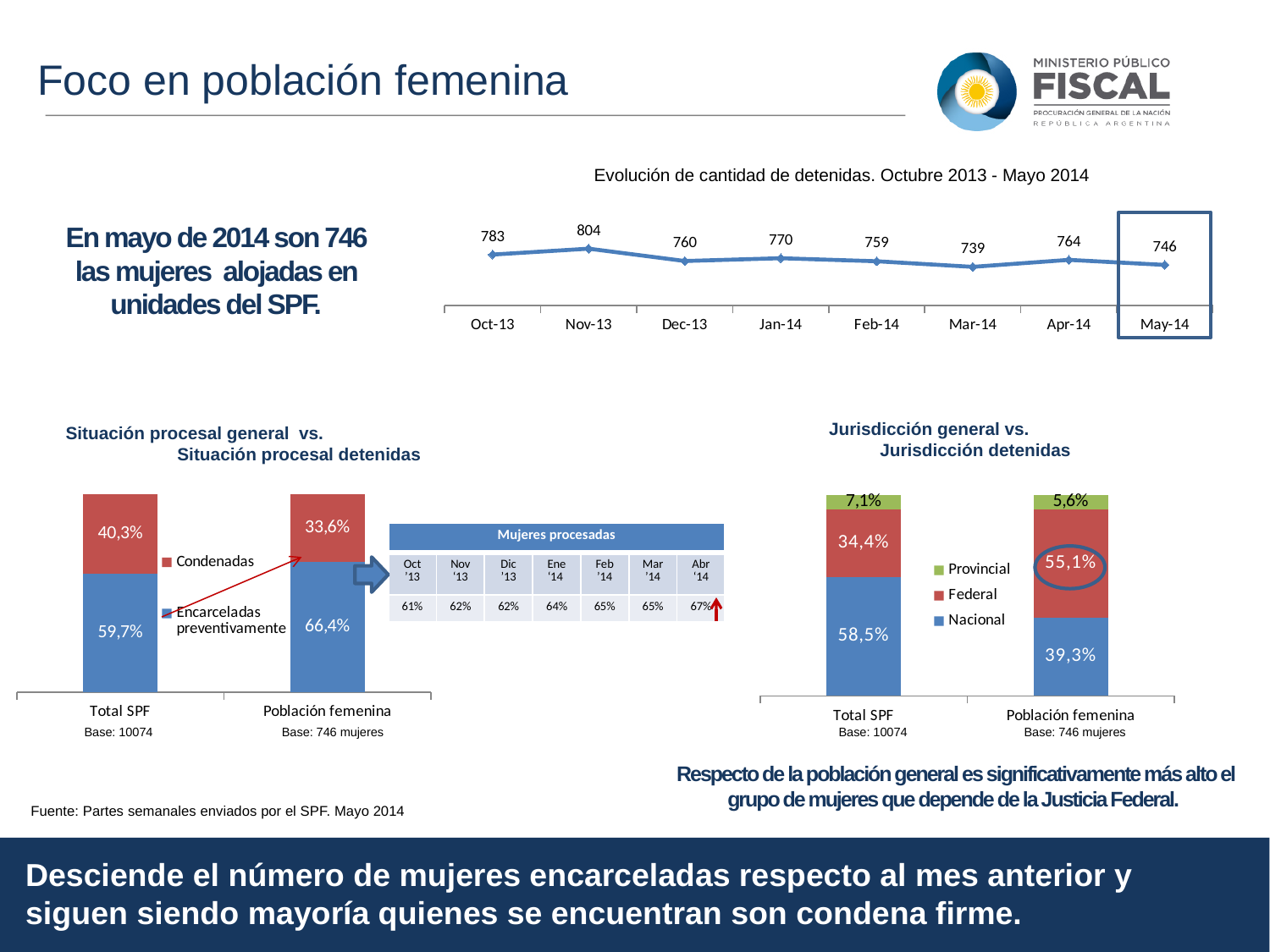
In the line chart 'Evolución de cantidad de detenidas', what is the value for Nov-13? 804 In the line chart 'Evolución de cantidad de detenidas', is the value for Oct-13 larger or smaller than the value for Dec-13? larger In the chart 'Jurisdicción general vs. Jurisdicción detenidas', what is the difference between the Nacional shares for Total SPF and Población femenina? 19,2% In the line chart 'Evolución de cantidad de detenidas', how many months are plotted? 8 In the line chart 'Evolución de cantidad de detenidas', what is the difference between the values for Apr-14 and May-14? 18 In the chart 'Situación procesal general vs. Situación procesal detenidas', what is the Condenadas share for Población femenina? 33,6% In the chart 'Jurisdicción general vs. Jurisdicción detenidas', what is the Federal share for Población femenina? 55,1% What kind of chart is 'Jurisdicción general vs. Jurisdicción detenidas'? stacked bar chart In the chart 'Situación procesal general vs. Situación procesal detenidas', what is the Encarceladas preventivamente share for Total SPF? 59,7% In the line chart 'Evolución de cantidad de detenidas', which month has the lowest value? Mar-14 In the chart 'Situación procesal general vs. Situación procesal detenidas', how many series does the legend list? 2 In the line chart 'Evolución de cantidad de detenidas', which month has the highest value? Nov-13